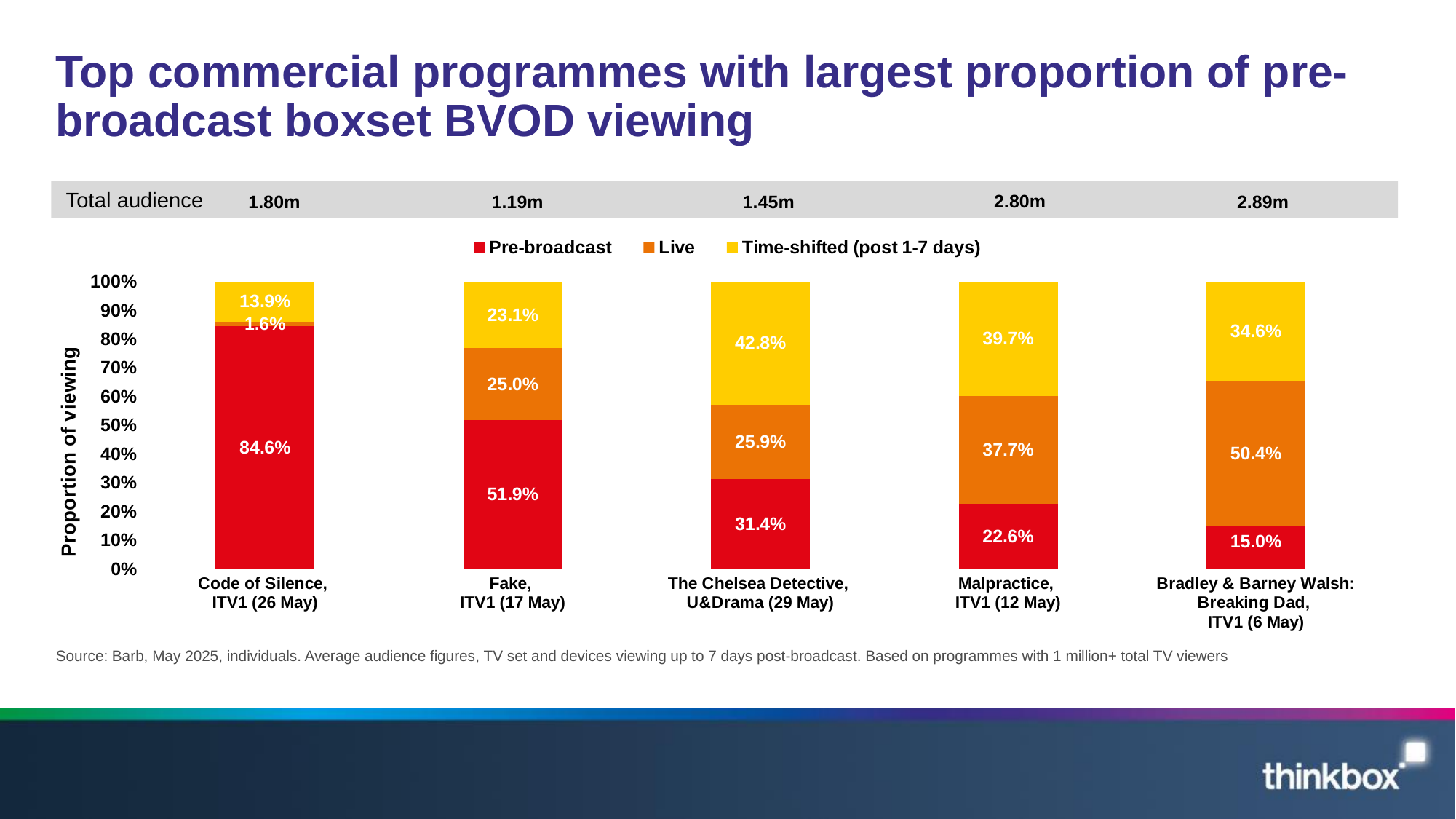
Which programme has the lowest Live share of viewing? Code of Silence, ITV1 (26 May) What is the Pre-broadcast share of viewing for Code of Silence, ITV1 (26 May)? 84.6% What is the Pre-broadcast share of viewing for Bradley & Barney Walsh: Breaking Dad, ITV1 (6 May)? 15.0% Which has the larger Live share of viewing: Malpractice or The Chelsea Detective? Malpractice, ITV1 (12 May) How many programmes are shown on the chart? 5 Which programme has the highest Pre-broadcast share of viewing? Code of Silence, ITV1 (26 May) What is the Time-shifted (post 1-7 days) share for The Chelsea Detective, U&Drama (29 May)? 42.8% What is the Live share of viewing for Fake, ITV1 (17 May)? 25.0% What kind of chart is shown on the slide? Stacked bar chart How many series does the legend list? 3 How much larger is the Pre-broadcast share for Code of Silence than for Fake, in percentage points? 32.7 percentage points Which programme has the highest Live share of viewing? Bradley & Barney Walsh: Breaking Dad, ITV1 (6 May)